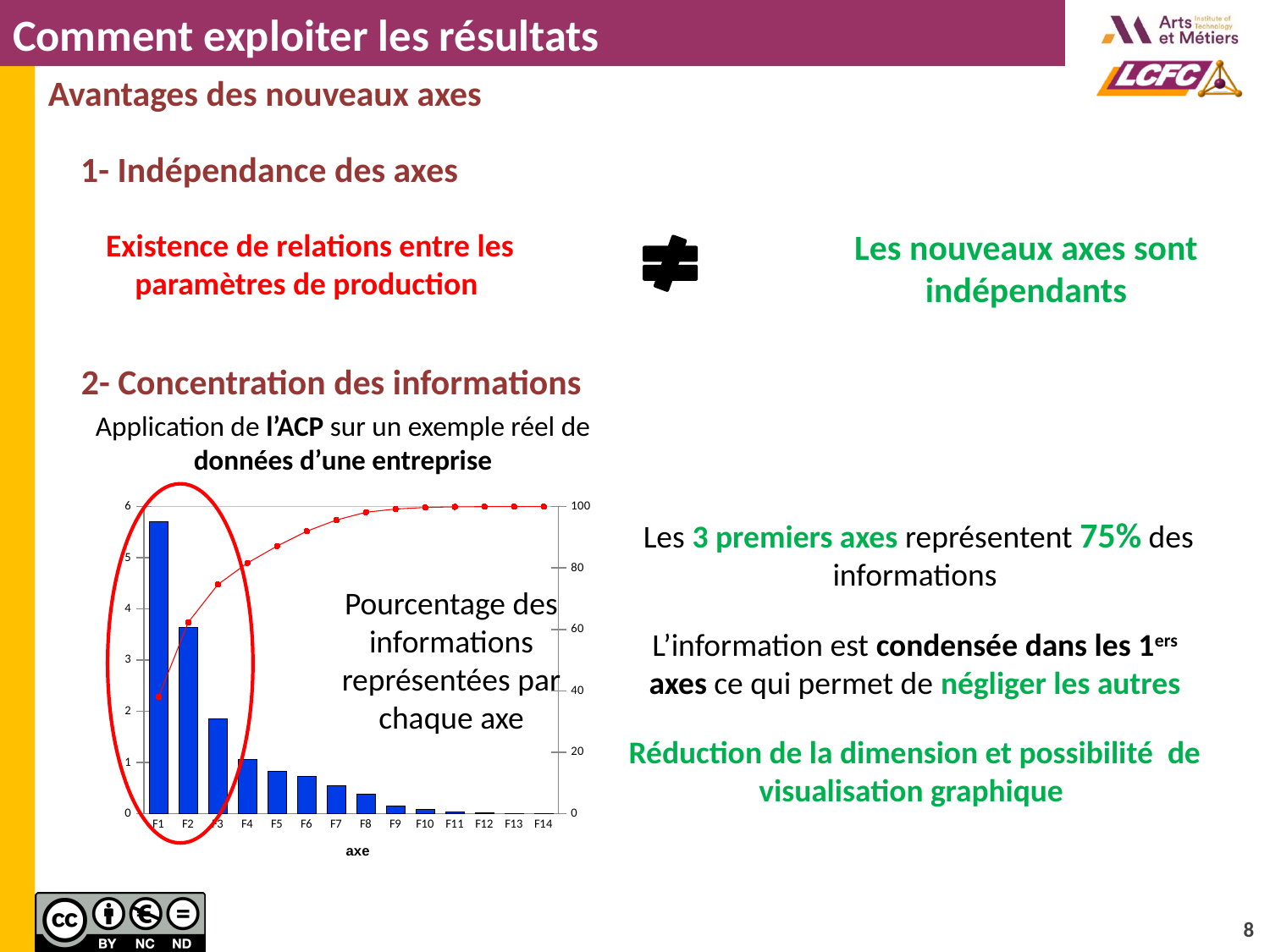
Is the bar value for F1 greater or less than 5 on the left axis? greater How many categories (axes F1 to F14) are plotted on the x axis of the chart? 14 What is the title of the x axis of the chart? axe Do the bar values rise or fall from F1 to F14 along the x axis? fall Which bar is taller, F2 or F3? F2 What kind of chart is shown on the slide? bar chart with a line Does the red line rise or fall from F1 to F14? rise What is the maximum value shown on the right-hand axis of the chart? 100 Is the bar value for F5 greater or less than 1 on the left axis? less Is the bar value for F3 greater or less than 2 on the left axis? less Which category has the tallest bar in the chart? F1